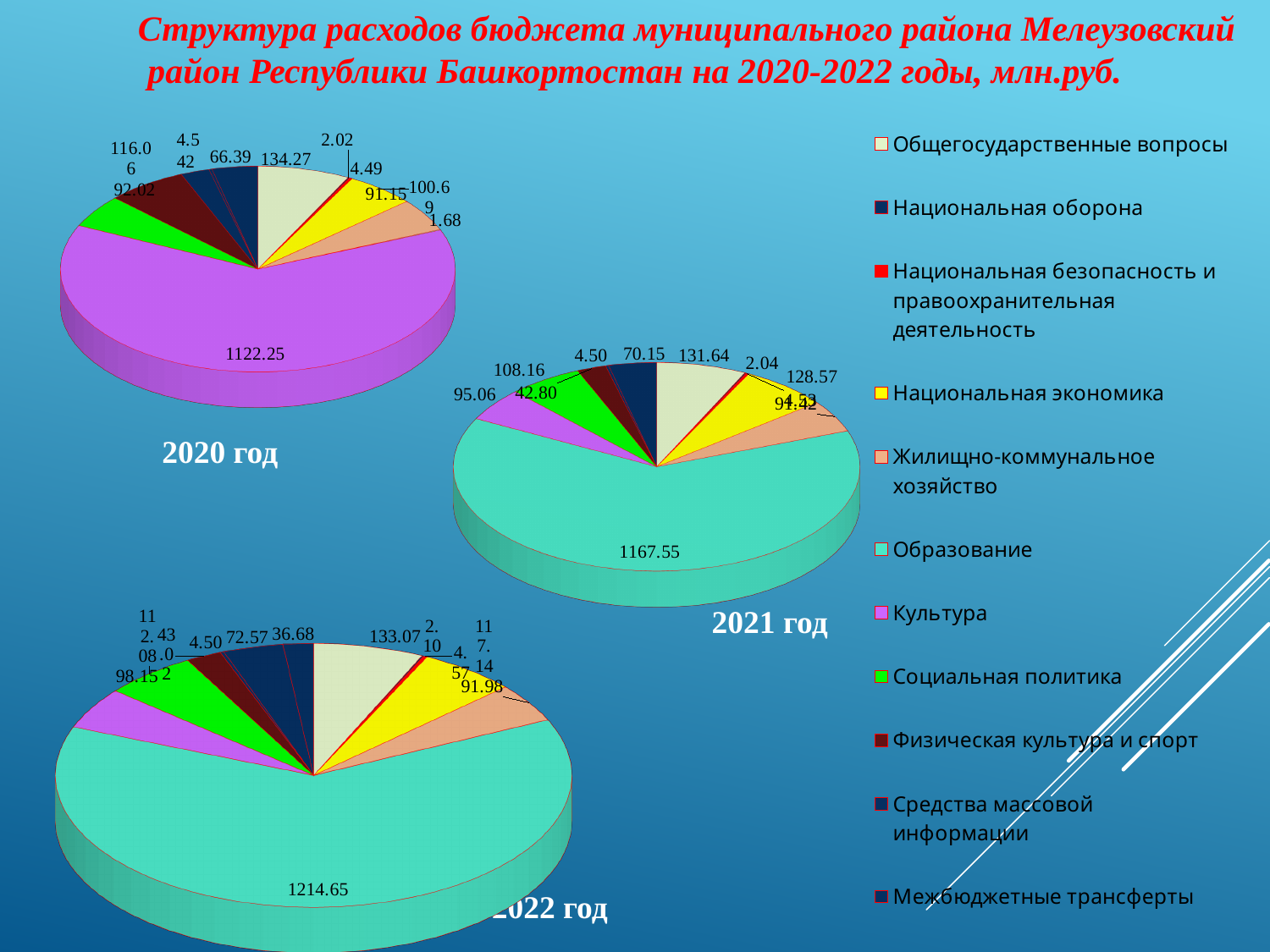
In the 2020 год chart, what is the value for Общегосударственные вопросы? 134.27 By how much does the value for Образование in the 2022 год chart exceed the value in the 2021 год chart? 47.10 In the 2021 год chart, what is the value for Национальная экономика? 128.57 In the 2021 год chart, what is the value for Образование? 1167.55 In the 2020 год chart, what is the value for Образование? 1122.25 How many categories does the legend list? 11 In the 2021 год chart, what is the value for Общегосударственные вопросы? 131.64 In the 2022 год chart, what is the value for Образование? 1214.65 In the 2021 год chart, which is larger: Культура or Социальная политика? Социальная политика How many pie charts are shown on the slide? 3 In the 2021 год chart, which category has the largest slice? Образование What kind of chart is used on this slide for each year? Pie chart